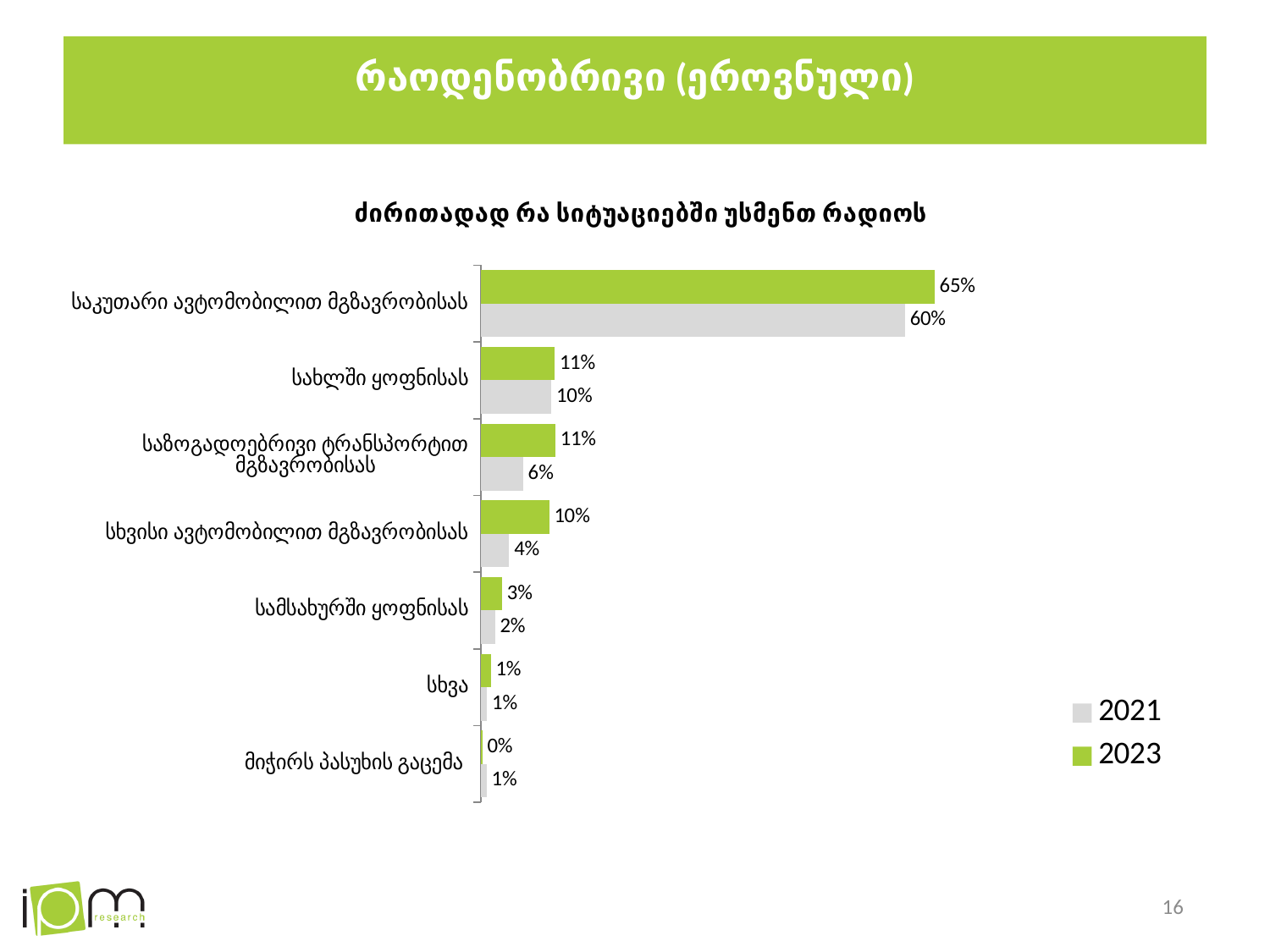
What is the 2021 value for "საზოგადოებრივი ტრანსპორტით მგზავრობისას"? 6% Which category has the highest 2023 value? საკუთარი ავტომობილით მგზავრობისას What is the 2023 value for "მიჭირს პასუხის გაცემა"? 0% How many series does the legend list? 2 What is the 2021 value for "სხვისი ავტომობილით მგზავრობისას"? 4% What is the 2023 value for "საკუთარი ავტომობილით მგზავრობისას"? 65% Which category has the lowest 2023 value? მიჭირს პასუხის გაცემა What is the difference between the 2023 and 2021 values for "საკუთარი ავტომობილით მგზავრობისას"? 5% What kind of chart is shown on the slide? Bar chart Which is larger for "საზოგადოებრივი ტრანსპორტით მგზავრობისას": the 2021 value or the 2023 value? 2023 What is the difference between the 2023 and 2021 values for "სხვისი ავტომობილით მგზავრობისას"? 6% How many categories are shown in the chart? 7